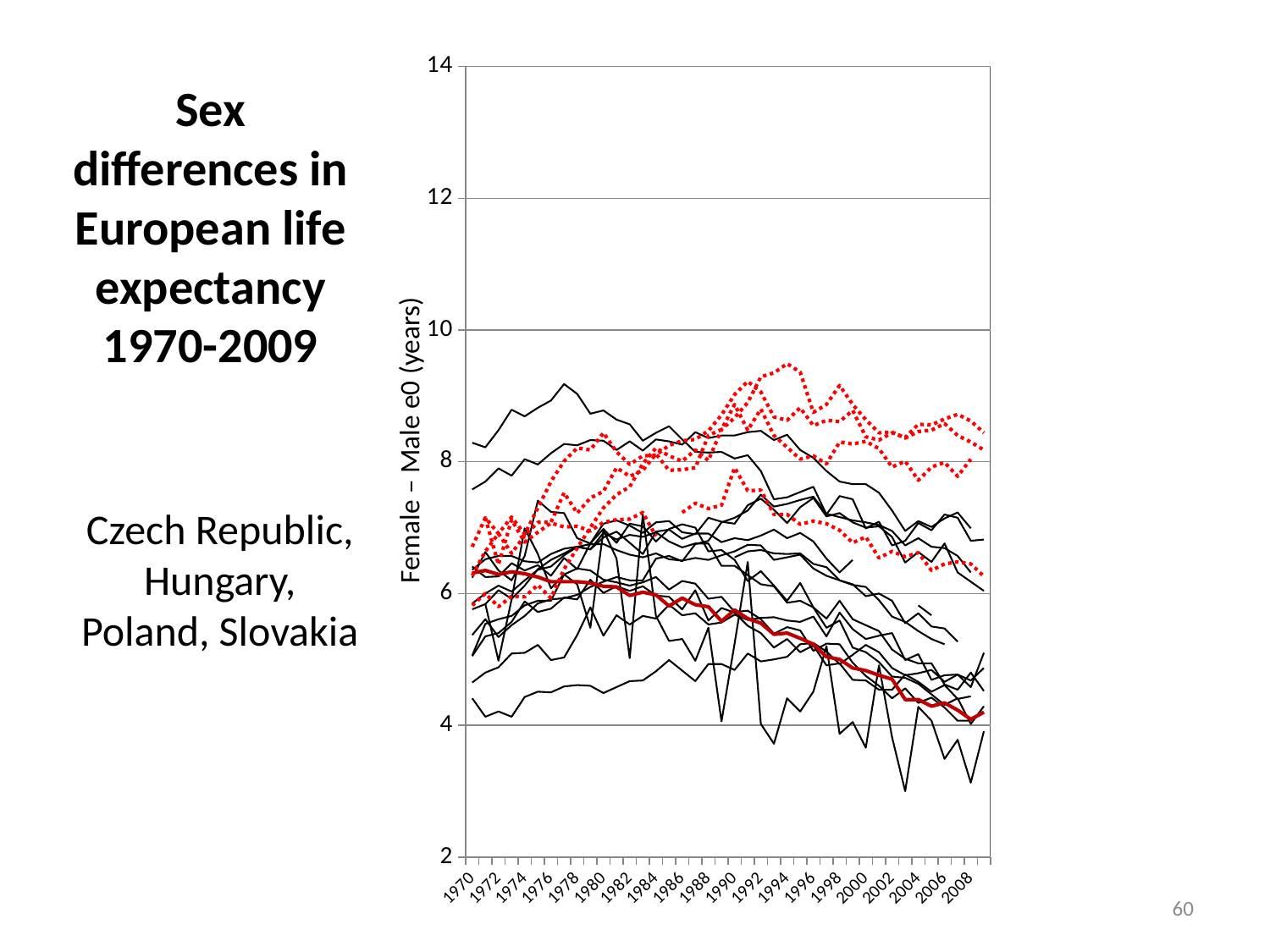
What is the highest value shown on the vertical axis of the chart? 14 Does the thick solid red line rise or fall from 1970 to 2009? fall Is the value of the thick solid red line in 1970 greater or less than 6? greater What kind of chart is shown on the slide? line chart What is the label on the vertical axis of the chart? Female – Male e0 (years) What is the lowest value shown on the vertical axis of the chart? 2 Is the value of the thick solid red line in 2008 greater or less than 6? less What is the first year labelled on the horizontal axis? 1970 What is the last year labelled on the horizontal axis? 2008 Which four countries does the slide say the chart covers? Czech Republic, Hungary, Poland, Slovakia How many year labels are printed along the horizontal axis? 20